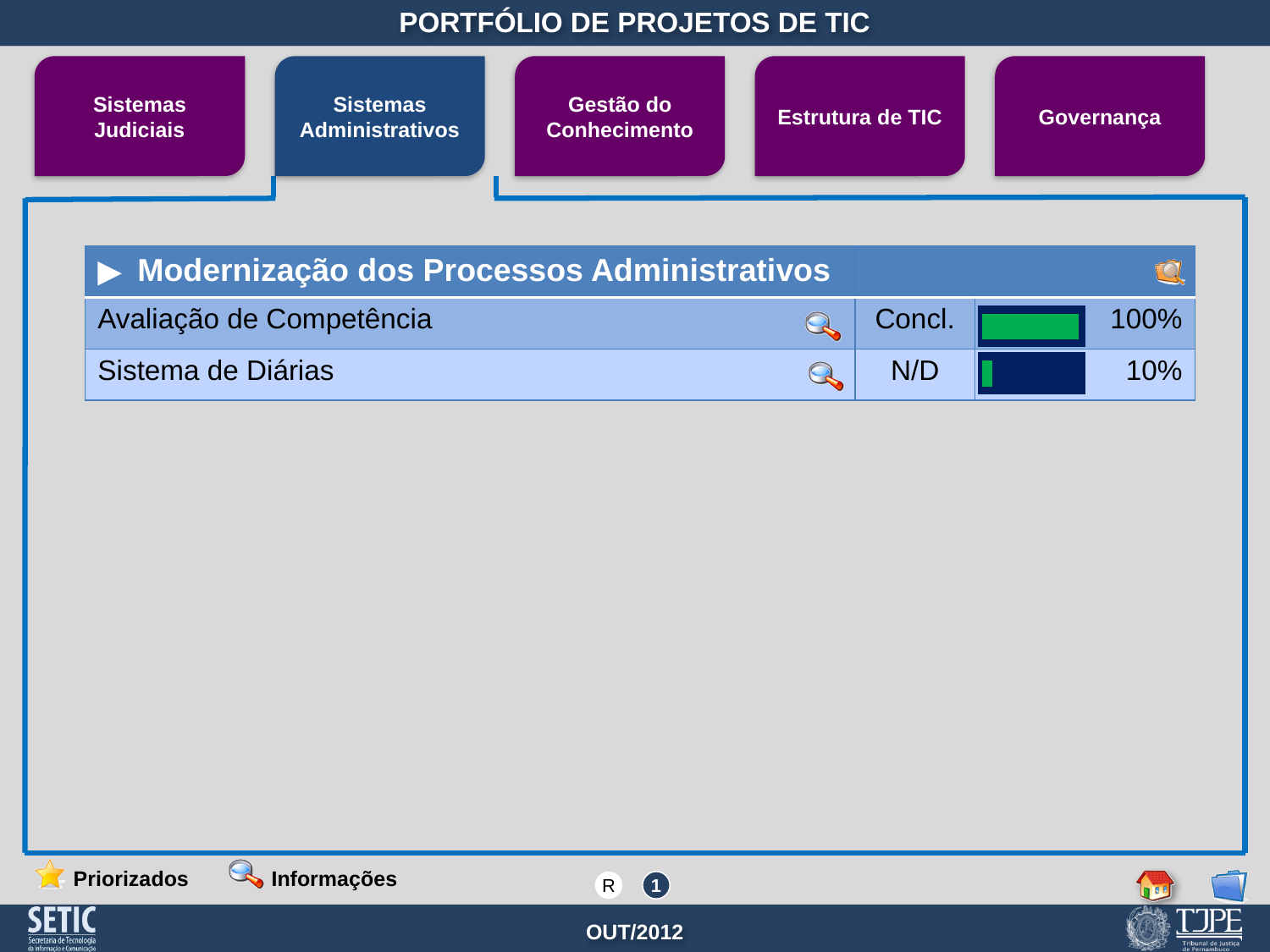
What status is shown for Sistema de Diárias? N/D Which project has the highest progress percentage? Avaliação de Competência What is the difference in progress percentage between Avaliação de Competência and Sistema de Diárias? 90% Which tab is highlighted in blue at the top of the slide? Sistemas Administrativos What is the progress percentage shown for Sistema de Diárias? 10% What is the progress percentage shown for Avaliação de Competência? 100% Which project has the lowest progress percentage? Sistema de Diárias What status is shown for Avaliação de Competência? Concl. Which project has a larger progress percentage, Avaliação de Competência or Sistema de Diárias? Avaliação de Competência How many projects are listed under Modernização dos Processos Administrativos? 2 What is the title of the project group shown in the table? Modernização dos Processos Administrativos